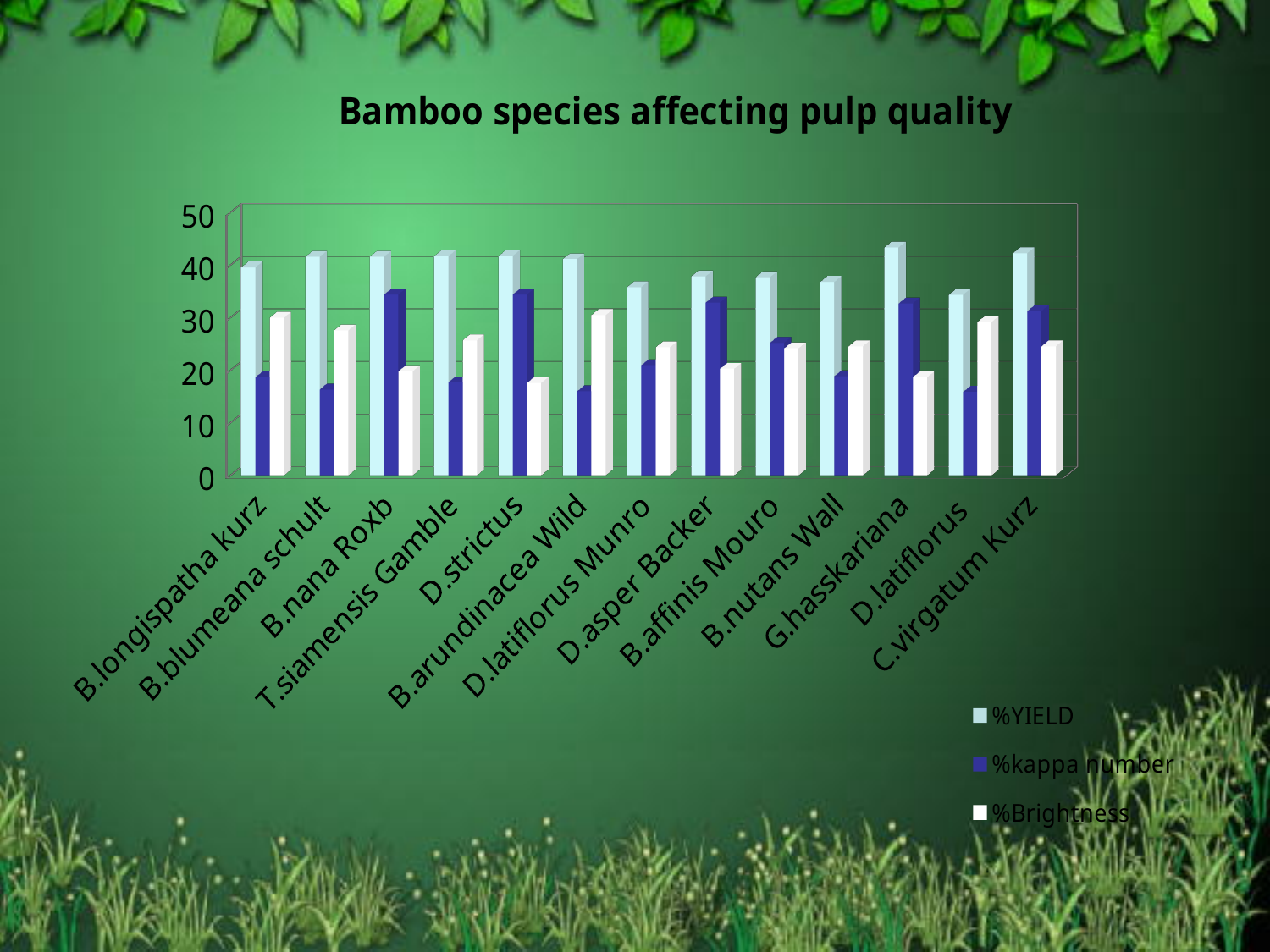
Which series is shown in dark blue in the legend? %kappa number How many bamboo species are shown on the x axis? 13 What kind of chart is shown on the slide? bar chart Is the %kappa number value for B.blumeana schult greater or less than 20? less How many series does the legend list? 3 Is the %YIELD value for D.latiflorus greater or less than 40? less For B.nana Roxb, which is larger: %kappa number or %Brightness? %kappa number Which has the larger %Brightness value: B.arundinacea Wild or D.strictus? B.arundinacea Wild Is the %kappa number value for D.latiflorus greater or less than 20? less What is the title of the chart? Bamboo species affecting pulp quality For B.longispatha kurz, which is larger: %YIELD or %kappa number? %YIELD